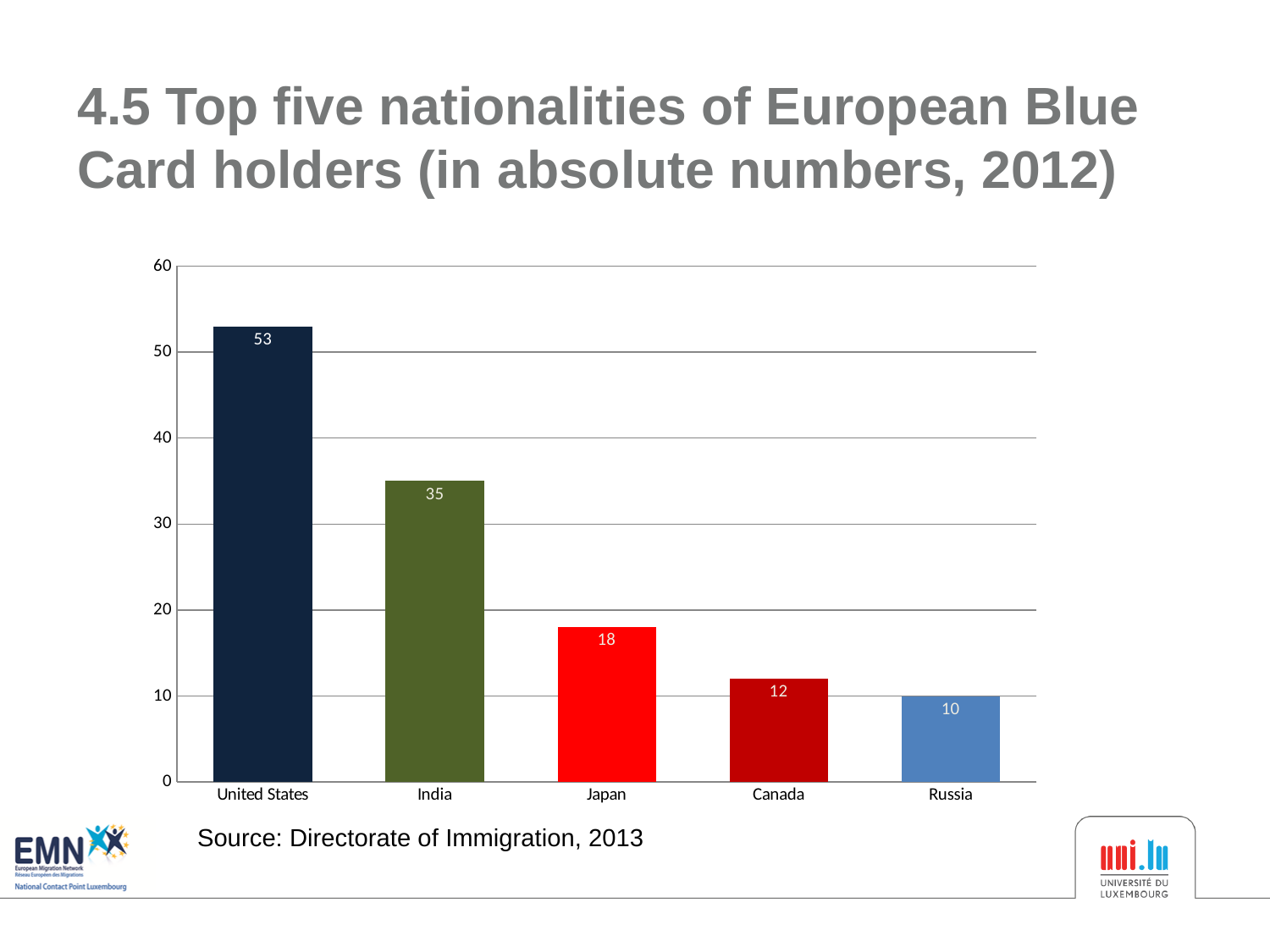
What is the value for the United States? 53 Which nationality has the highest number of Blue Card holders? United States Which is larger, the value for Canada or the value for Russia? Canada What is the value for Japan? 18 What is the difference between the values for the United States and India? 18 How many nationalities are shown in the chart? 5 What kind of chart is shown on the slide? Bar chart What is the value for India? 35 What is the difference between the values for Japan and Canada? 6 Which nationality has the lowest number of Blue Card holders? Russia What is the value for Russia? 10 Do the values rise or fall from left to right along the x axis? Fall